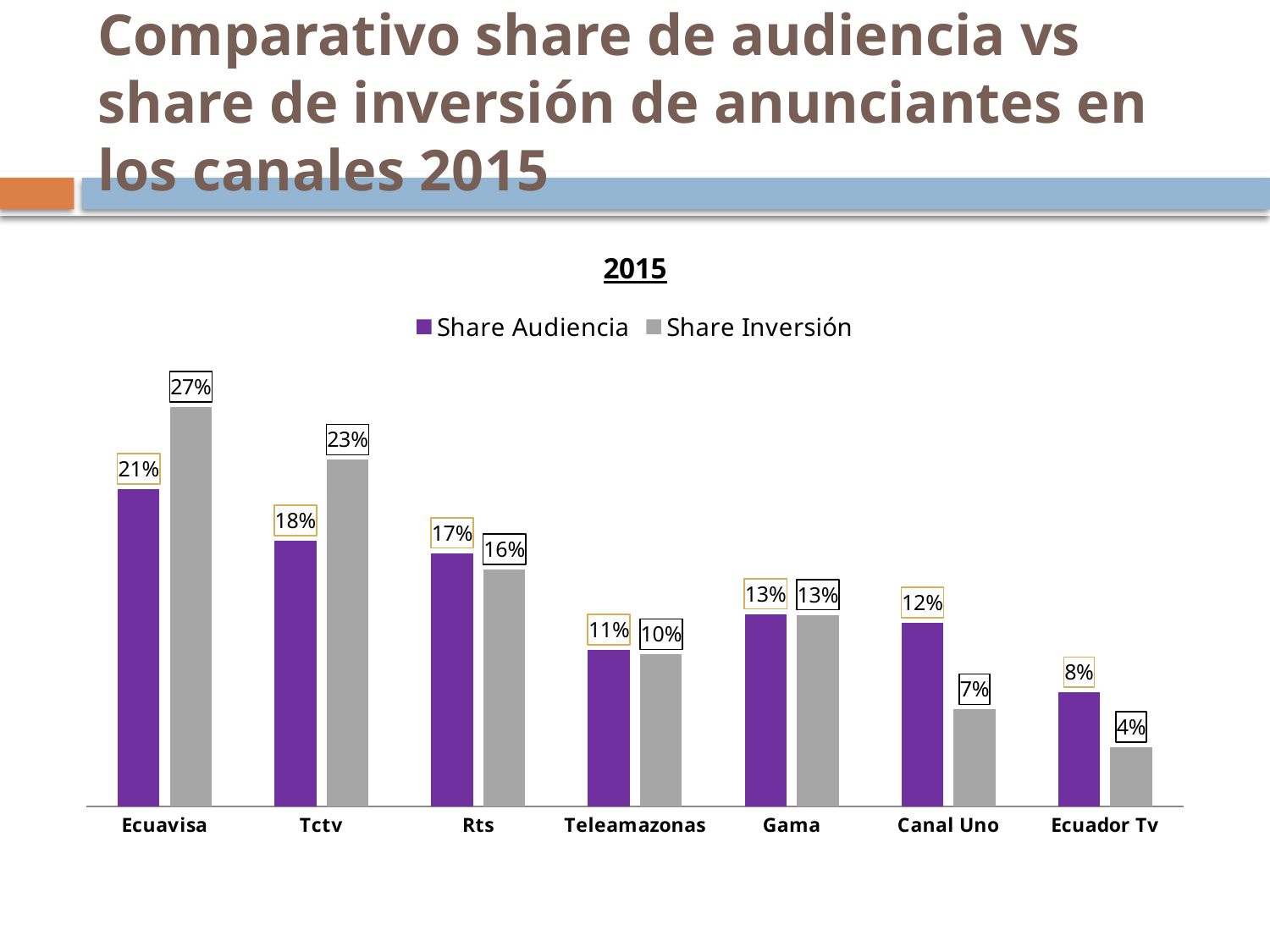
What is the difference between Share Inversión and Share Audiencia for Ecuavisa? 6% Which channel has the lowest Share Audiencia? Ecuador Tv What is the Share Audiencia value for Ecuavisa? 21% How many channels are shown on the x axis? 7 What is the title shown above the chart legend? 2015 Which is larger for Rts, Share Audiencia or Share Inversión? Share Audiencia What kind of chart is shown on the slide? Bar chart What is the difference between Share Audiencia and Share Inversión for Canal Uno? 5% What is the Share Inversión value for Canal Uno? 7% What is the Share Inversión value for Tctv? 23% How many series does the legend list? 2 Which channel has the highest Share Inversión? Ecuavisa